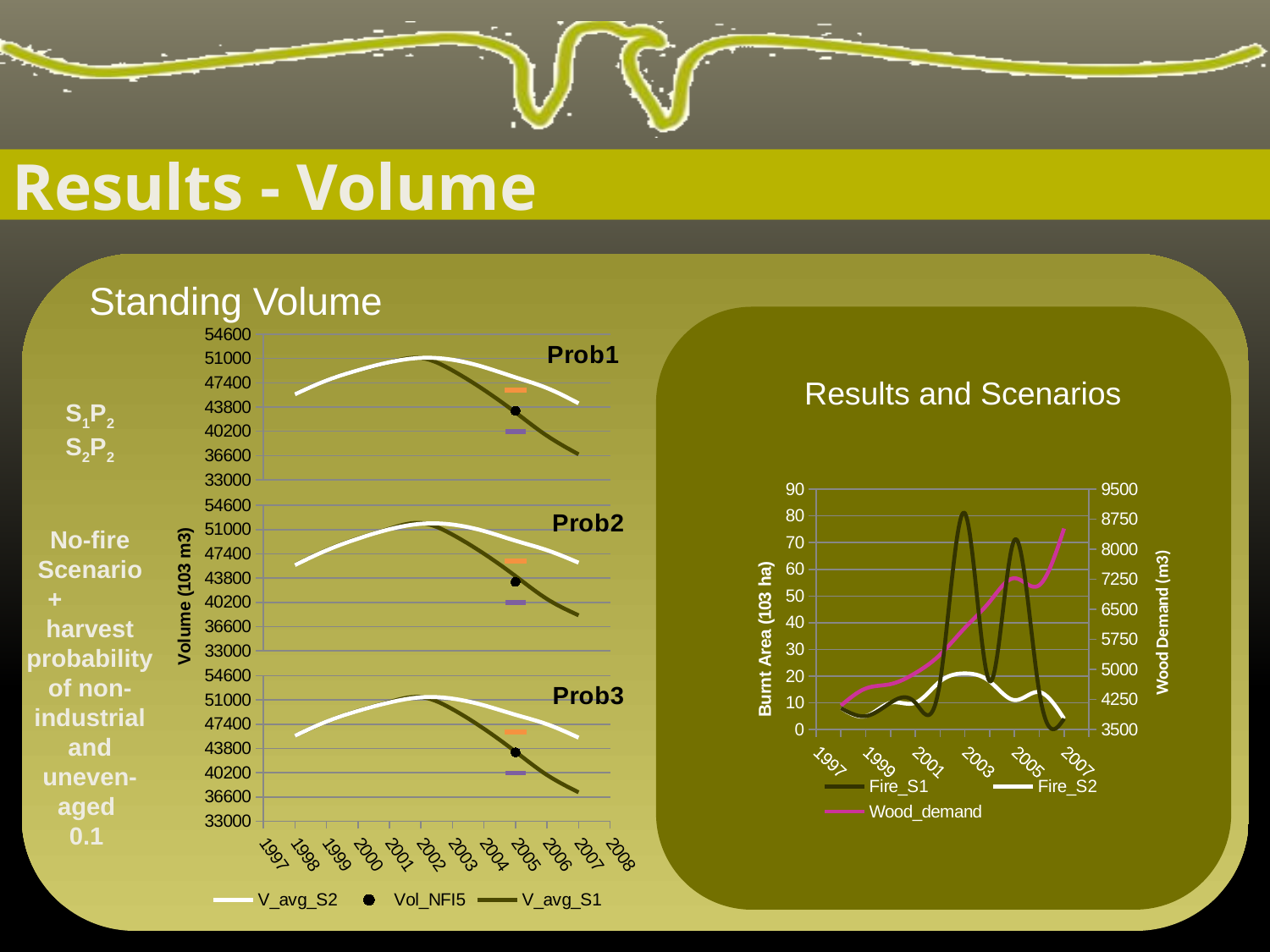
In the 'Results and Scenarios' chart, which series reaches a higher value in 2003, Fire_S1 or Fire_S2? Fire_S1 In the 'Results and Scenarios' chart, is the peak value of Fire_S2 greater or less than 30? less What kind of chart is the 'Results and Scenarios' chart? line chart How many series does the legend of the 'Results and Scenarios' chart list? 3 In the Prob1 'Standing Volume' chart, is the V_avg_S1 value in 2007 greater or less than 40200? less In the Prob3 'Standing Volume' chart, does V_avg_S1 rise or fall from 2002 to 2007? fall In the 'Results and Scenarios' chart, does Wood_demand rise or fall from 1997 to 2007? rise In the 'Results and Scenarios' chart, is the peak value of Fire_S1 in 2003 greater or less than 70? greater What is the label of the right-hand vertical axis of the 'Results and Scenarios' chart? Wood Demand (m3) In the Prob1 'Standing Volume' chart, which series is higher in 2007, V_avg_S2 or V_avg_S1? V_avg_S2 How many series does the legend of the 'Standing Volume' charts list? 3